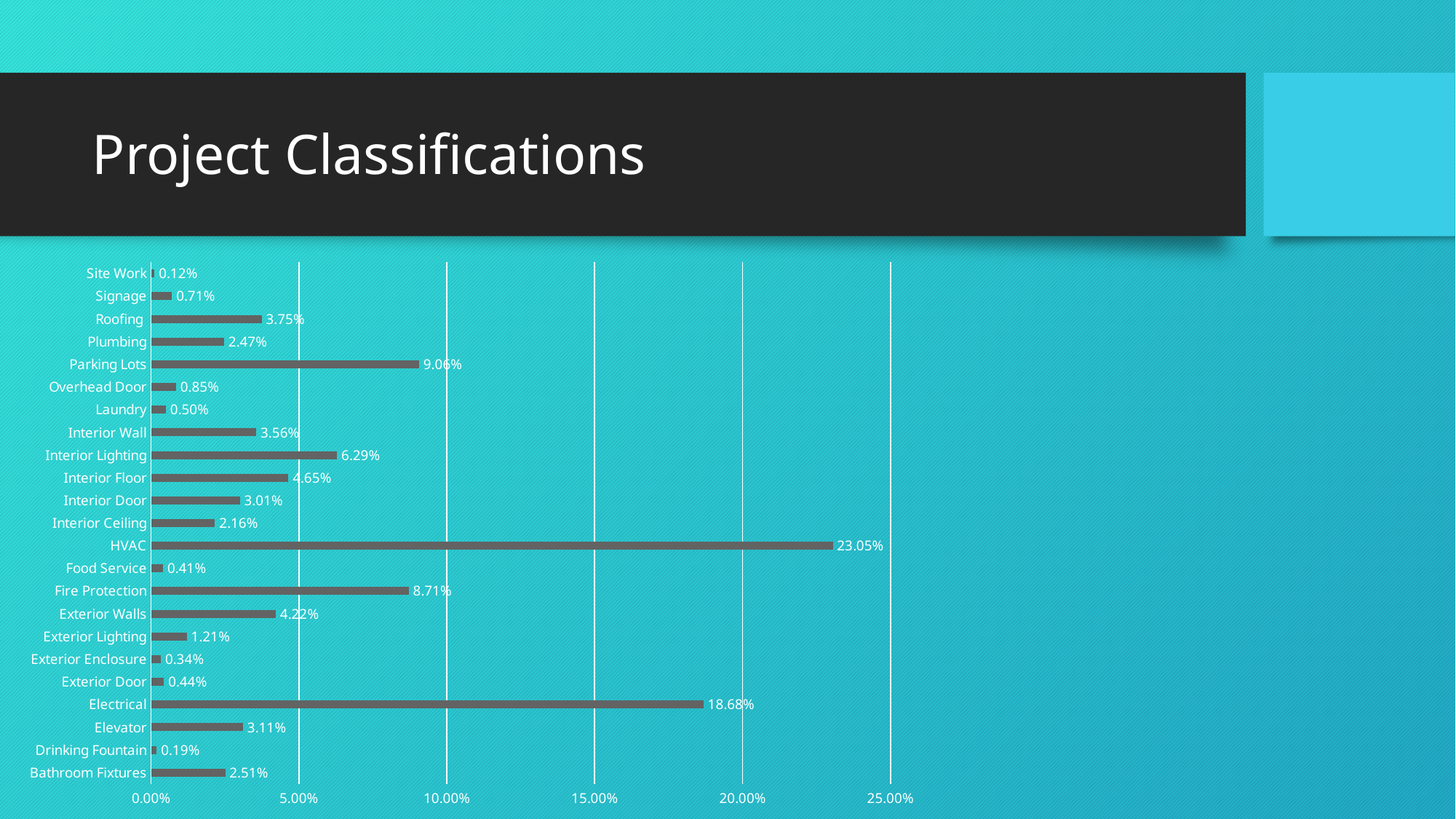
Which is larger, the value for Roofing or the value for Interior Wall? Roofing What is the value for Drinking Fountain? 0.19% Which category has the lowest value? Site Work What is the title of the slide containing the chart? Project Classifications What is the value for Parking Lots? 9.06% What is the value for Interior Lighting? 6.29% What is the difference between the values for HVAC and Electrical? 4.37% What is the value for HVAC? 23.05% How many categories are shown in the chart? 23 What kind of chart is shown on the slide? Bar chart Which category has the highest value? HVAC Is the value for Electrical greater or less than 20.00%? less